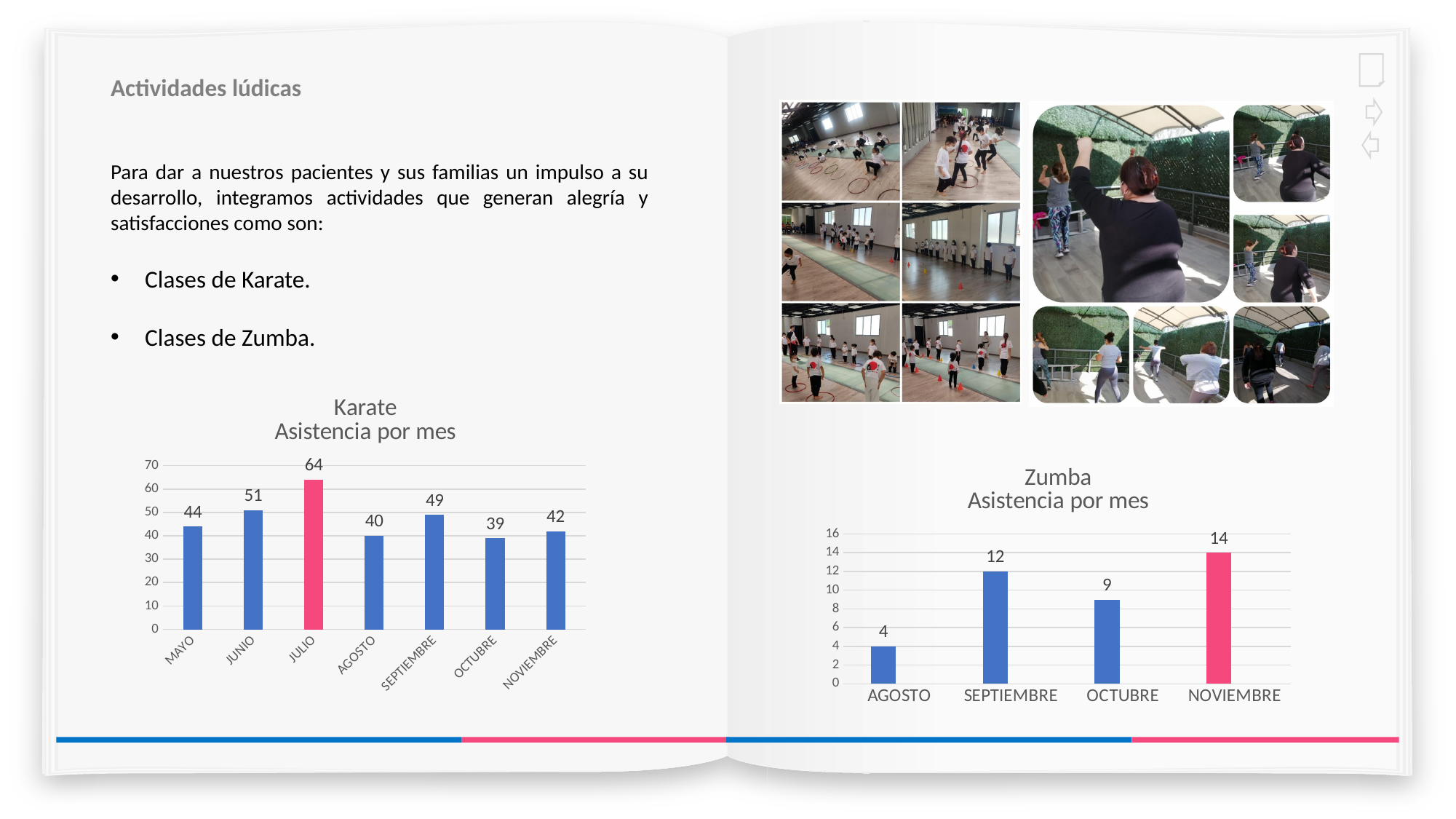
In the 'Karate Asistencia por mes' chart, which is larger, JUNIO or SEPTIEMBRE? JUNIO In the 'Karate Asistencia por mes' chart, which month has the highest attendance? JULIO What type of chart is the 'Zumba Asistencia por mes' chart? Bar chart In the 'Zumba Asistencia por mes' chart, how many months are shown? 4 In the 'Karate Asistencia por mes' chart, how many months are shown? 7 In the 'Karate Asistencia por mes' chart, what is the difference between JULIO and MAYO? 20 In the 'Zumba Asistencia por mes' chart, which bar is coloured pink instead of blue? NOVIEMBRE In the 'Zumba Asistencia por mes' chart, what is the difference between SEPTIEMBRE and AGOSTO? 8 In the 'Karate Asistencia por mes' chart, what is the value for JULIO? 64 In the 'Zumba Asistencia por mes' chart, what is the value for OCTUBRE? 9 In the 'Karate Asistencia por mes' chart, which month has the lowest attendance? OCTUBRE In the 'Zumba Asistencia por mes' chart, which month has the highest attendance? NOVIEMBRE